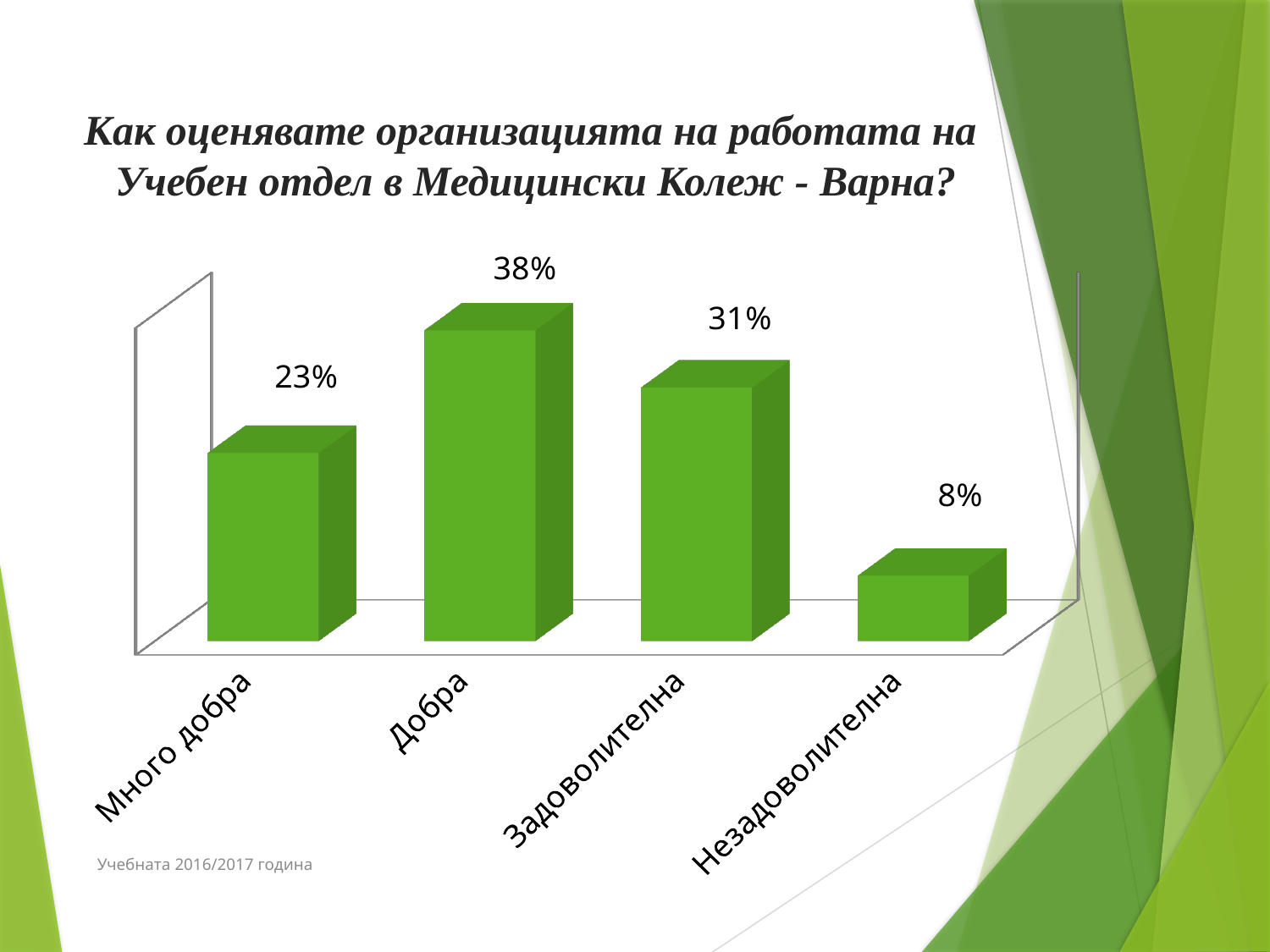
What is the difference between the values for Много добра and Незадоволителна? 15% How many categories are shown in the chart? 4 What is the value for Незадоволителна? 8% What is the value for Много добра? 23% What is the title of the chart? Как оценявате организацията на работата на Учебен отдел в Медицински Колеж - Варна? What is the difference between the values for Добра and Задоволителна? 7% Which category has the lowest value? Незадоволителна Which category has the highest value? Добра What is the value for Задоволителна? 31% What kind of chart is shown on the slide? Bar chart Which is larger, the value for Много добра or the value for Задоволителна? Задоволителна What is the value for Добра? 38%